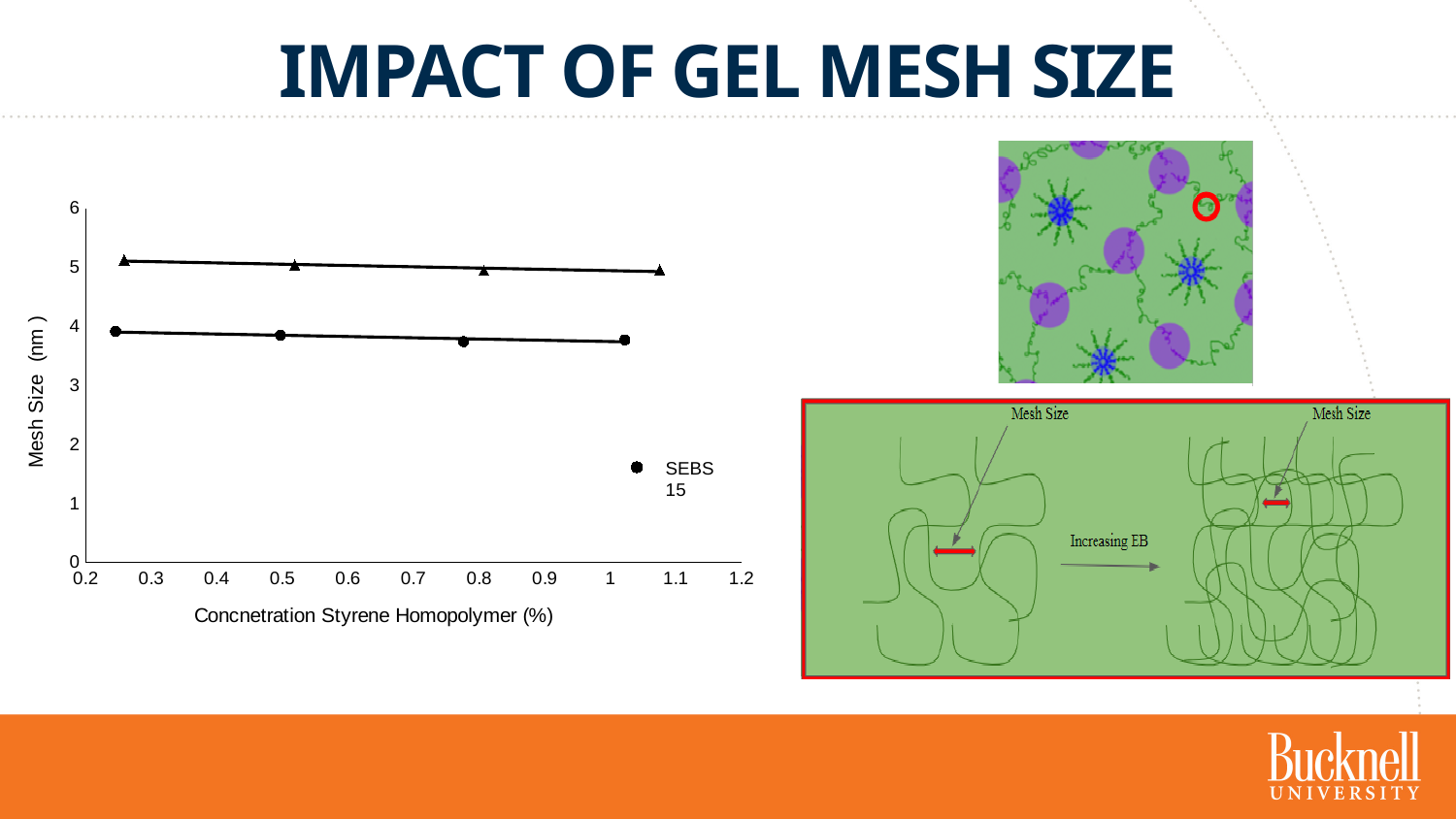
Are the triangle-marker points higher or lower in mesh size than the SEBS 15 circle points? higher What series name does the chart's legend list? SEBS 15 Is the SEBS 15 mesh size at the lowest plotted concentration greater or less than 3? greater Does the mesh size for SEBS 15 rise or fall as the concentration of styrene homopolymer increases? fall What kind of chart is shown on the slide? scatter chart How many data points are plotted for the SEBS 15 series? 4 Is the mesh size of the triangle-marker series at the lowest plotted concentration greater or less than 6? less How many data points are plotted with triangle markers? 4 Is the SEBS 15 mesh size at a concentration of about 1% greater or less than 4? less Does the mesh size for the triangle-marker series rise or fall as the concentration increases? fall What is the title of the x axis of the chart? Concnetration Styrene Homopolymer (%)